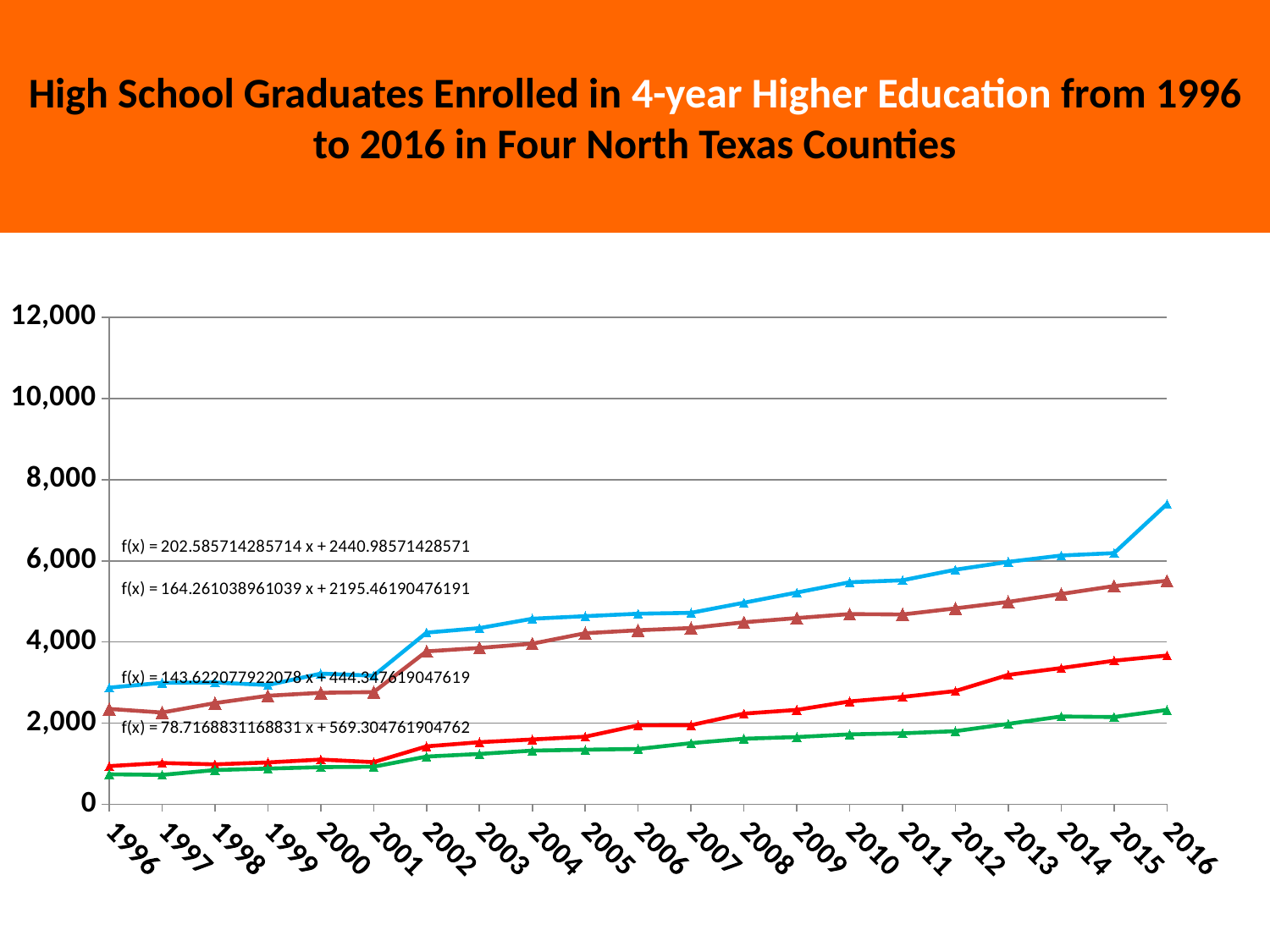
In which year does the blue line reach its highest value? 2016 Do the values of the blue line generally rise or fall from 1996 to 2016? rise Is the value of the red line in 2016 greater or less than 4,000? less Is the value of the blue line in 2016 greater or less than 6,000? greater In 2016, which line has the larger value, the blue line or the green line? blue line What kind of chart is shown on the slide? line chart How many years are shown along the x axis of the chart? 21 Is the value of the brown line in 2016 greater or less than 4,000? greater What is the trendline equation printed at the top of the chart, for the line with the largest slope? f(x) = 202.585714285714 x + 2440.98571428571 How many lines are plotted on the chart? 4